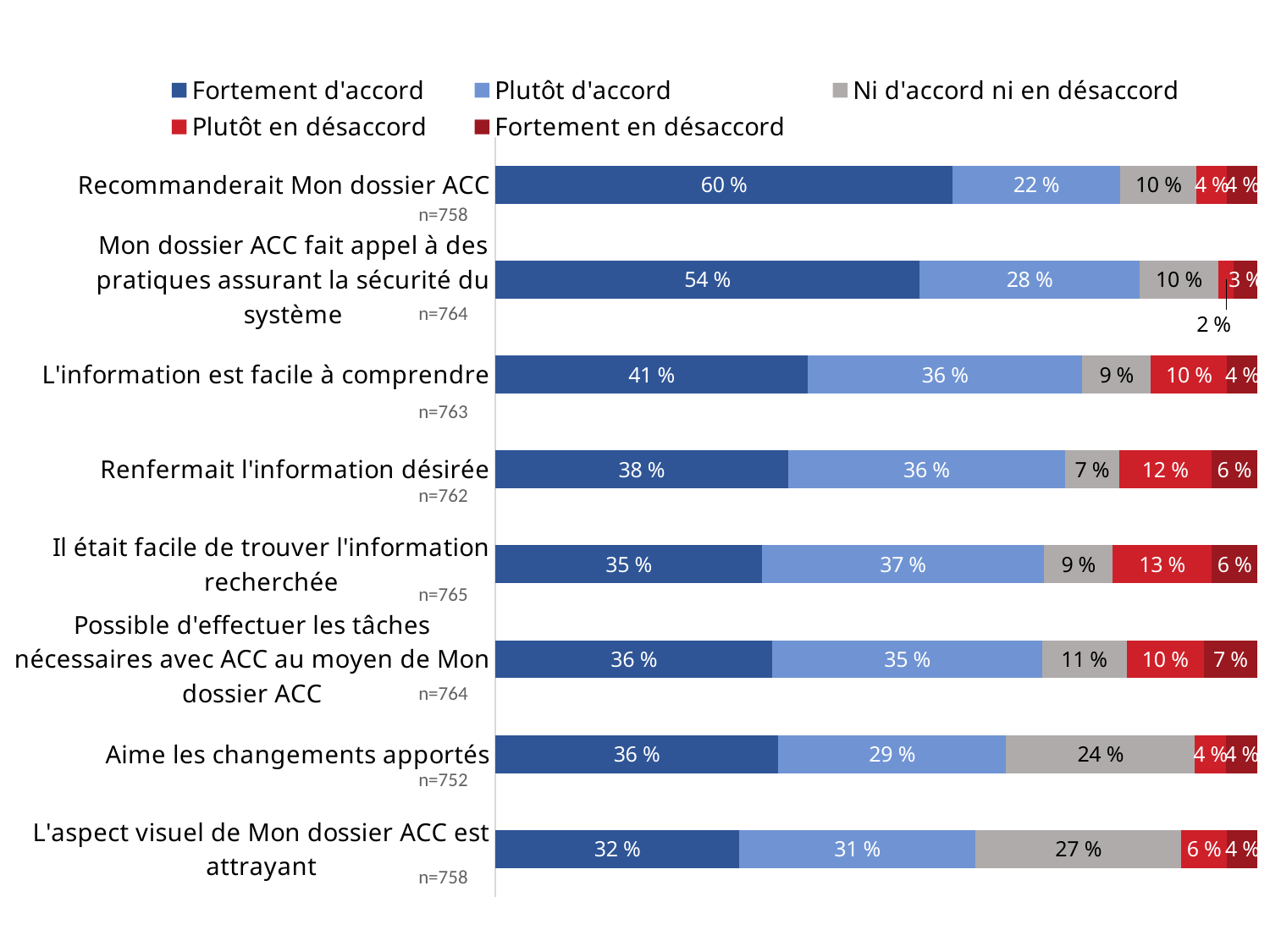
Which statement has the highest 'Plutôt en désaccord' value? Il était facile de trouver l'information recherchée What is the 'Fortement d'accord' value for 'Recommanderait Mon dossier ACC'? 60 % How many series does the legend list? 5 What is the 'Ni d'accord ni en désaccord' value for 'L'aspect visuel de Mon dossier ACC est attrayant'? 27 % How many categories (statements) are plotted on the chart? 8 What kind of chart is shown on the slide? Stacked bar chart What is the 'Plutôt d'accord' value for 'Mon dossier ACC fait appel à des pratiques assurant la sécurité du système'? 28 % What is the sample size (n) shown for 'Il était facile de trouver l'information recherchée'? n=765 What is the difference between the 'Fortement d'accord' values for 'Recommanderait Mon dossier ACC' and 'L'information est facile à comprendre'? 19 % Which is larger: the 'Ni d'accord ni en désaccord' value for 'Aime les changements apportés' or for 'Renfermait l'information désirée'? Aime les changements apportés Which statement has the highest 'Fortement d'accord' value? Recommanderait Mon dossier ACC Which statement has the lowest 'Fortement d'accord' value? L'aspect visuel de Mon dossier ACC est attrayant